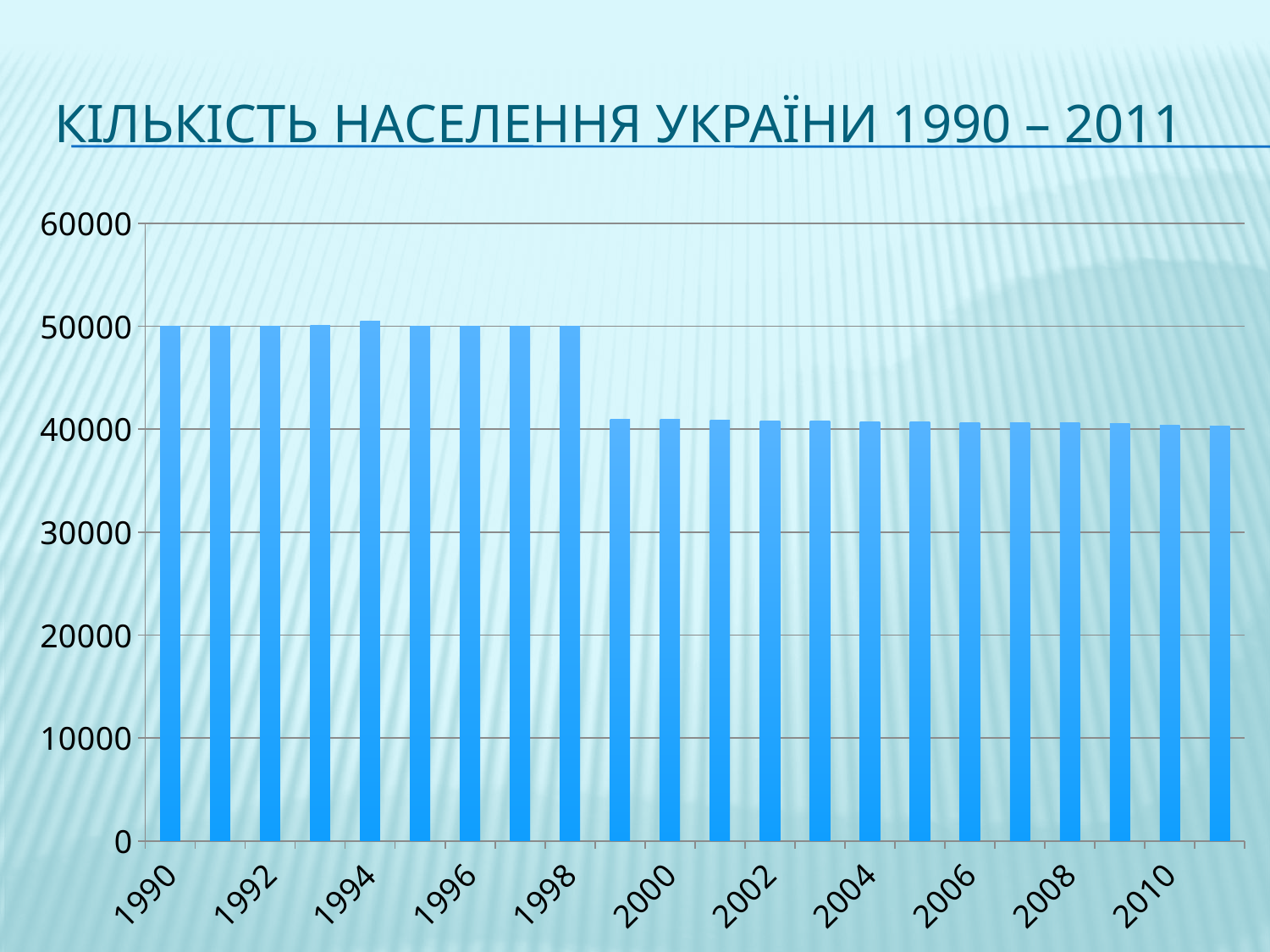
Do the values generally rise or fall from 1990 to 2011? fall Which year has the highest value in the chart? 1994 Which year has a larger value, 1990 or 2000? 1990 What kind of chart is shown on the slide? bar chart Is the value for 1996 greater or less than 60000? less What colour are the bars in the chart? blue What is the title of the chart? Кількість населення України 1990 – 2011 Is the value for 1990 greater or less than 40000? greater Is the value for 2002 greater or less than 30000? greater How many bars (years) are plotted in the chart? 22 Which year has a larger value, 2004 or 1998? 1998